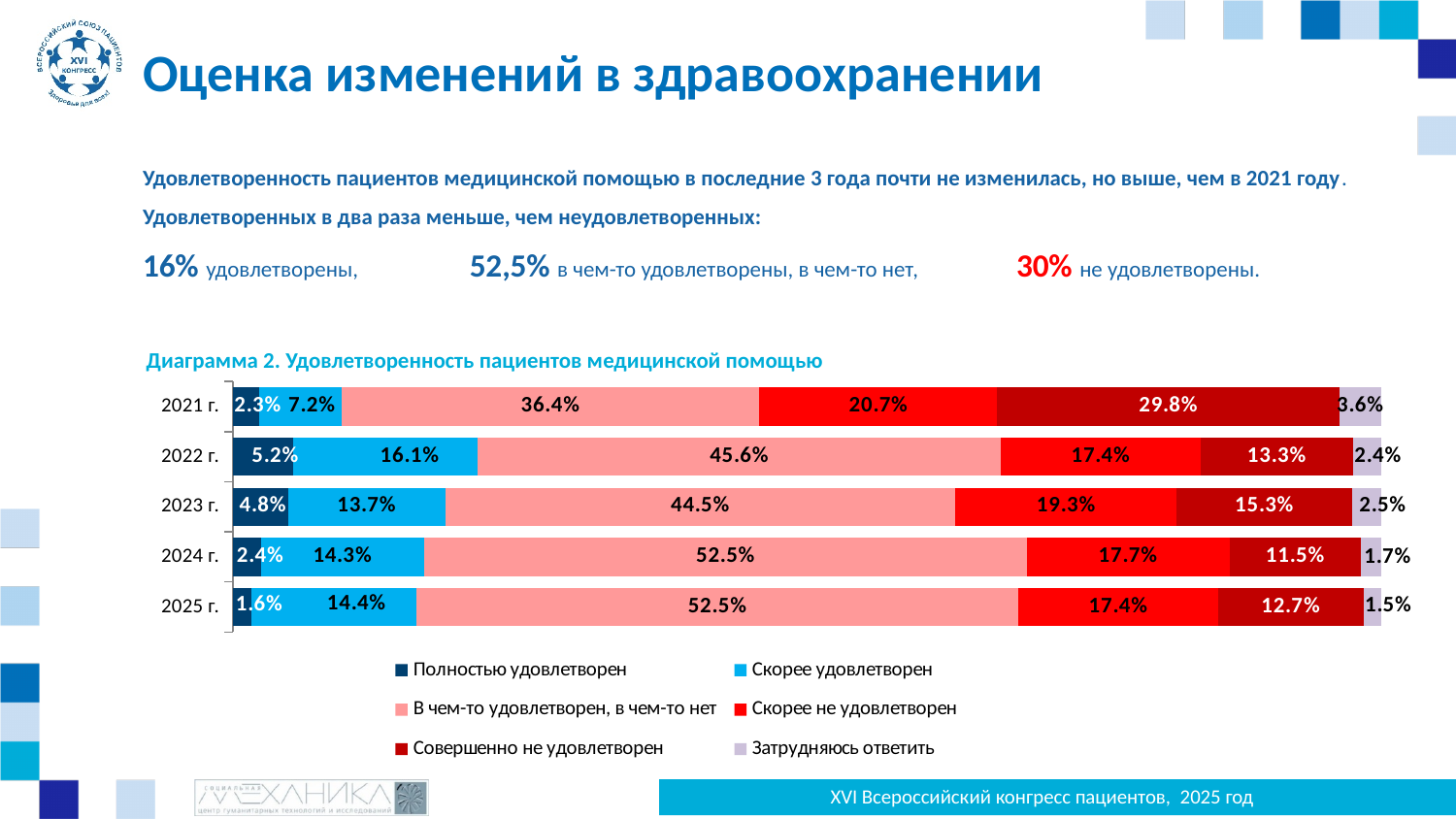
What type of chart is shown on the slide? Stacked bar chart Does the share of "В чем-то удовлетворен, в чем-то нет" rise or fall overall from 2021 to 2025? Rise What is the value for "Скорее удовлетворен" in 2022? 16.1% In which year is the share of "Совершенно не удовлетворен" the highest? 2021 What is the value for "В чем-то удовлетворен, в чем-то нет" in 2021? 36.4% What is the title of the chart? Диаграмма 2. Удовлетворенность пациентов медицинской помощью What is the difference between the "Совершенно не удовлетворен" values for 2021 and 2025? 17.1 percentage points Which year has the larger value for "Скорее не удовлетворен": 2023 or 2024? 2023 In which year is the share of "Полностью удовлетворен" the lowest? 2025 What is the value for "Совершенно не удовлетворен" in 2025? 12.7% How many series does the chart legend list? 6 How many years (categories) are shown in the chart? 5